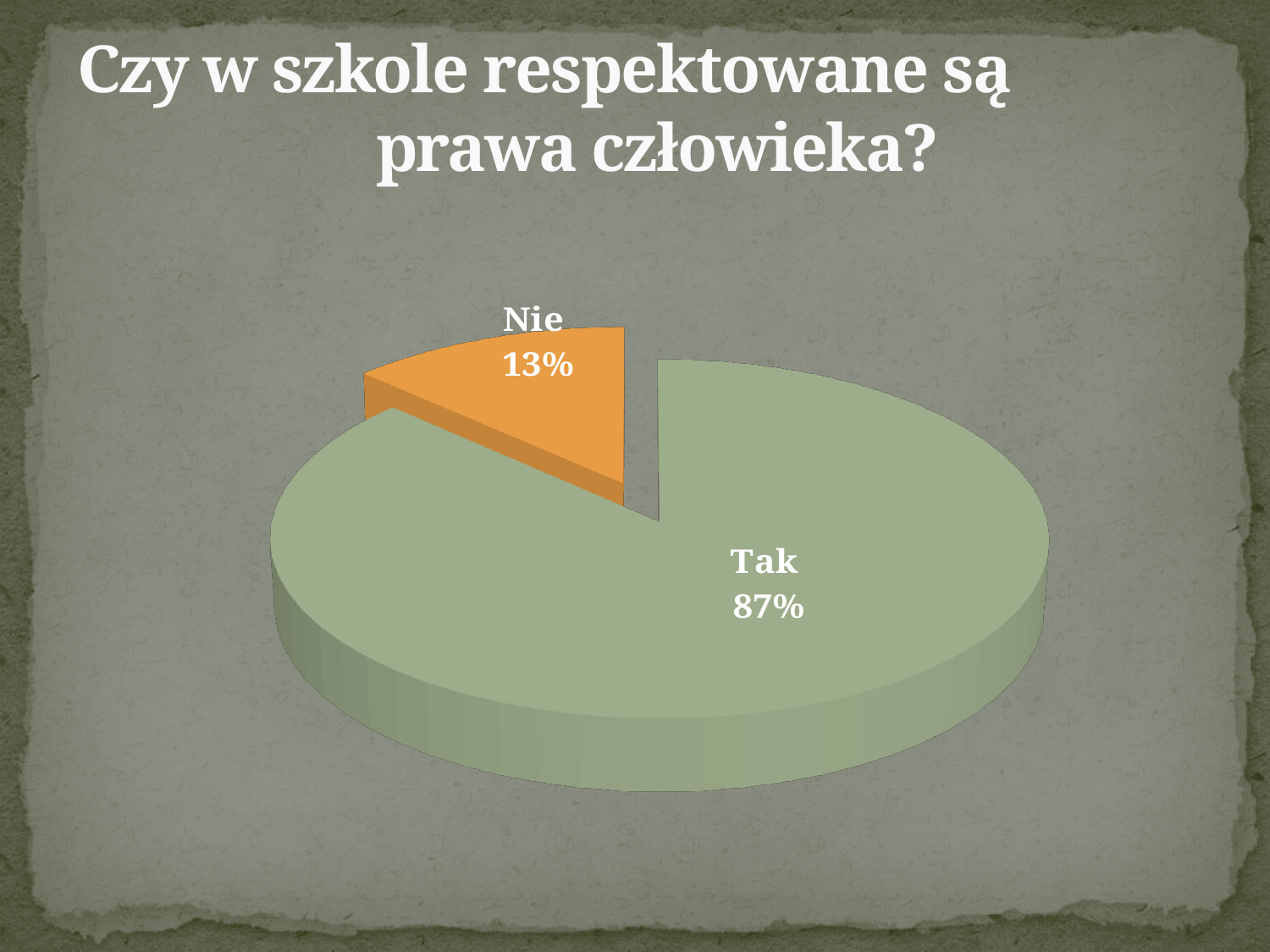
What is the difference in percentage points between the "Tak" and "Nie" slices? 74 Which slice of the pie is the largest? Tak Which is larger, the "Tak" slice or the "Nie" slice? Tak What is the title of the slide above the chart? Czy w szkole respektowane są prawa człowieka? What kind of chart is shown on the slide? Pie chart What percentage of responses are "Nie"? 13% What percentage of responses are "Tak"? 87% Which slice of the pie is the smallest? Nie What share of the pie does the "Nie" slice represent? 13% What colour is the "Nie" slice? Orange How many slices does the pie chart have? 2